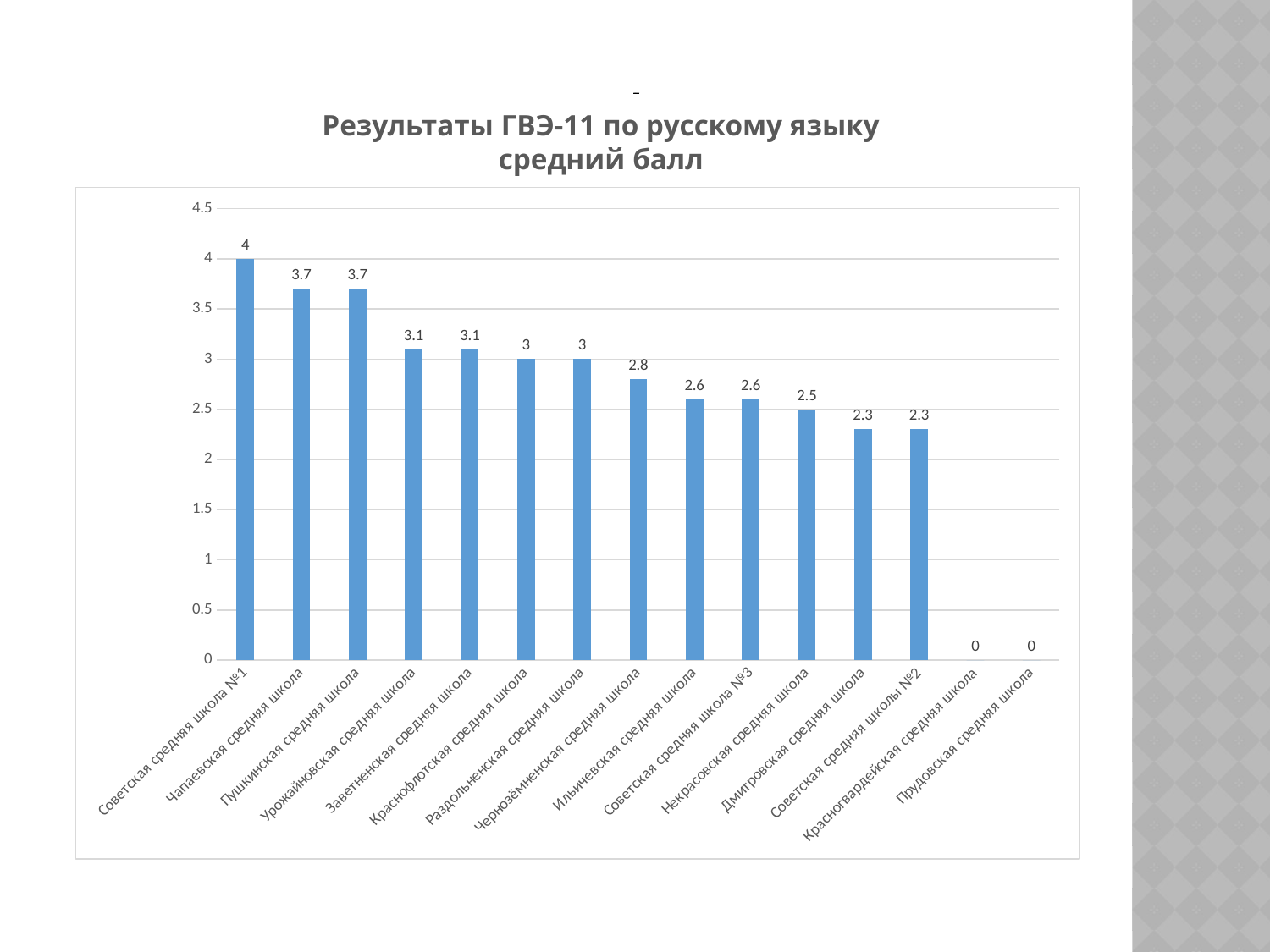
What kind of chart is shown on the slide? bar chart Which school has the highest average score? Советская средняя школа №1 What is the value shown for Чернозёмненская средняя школа? 2.8 What is the value shown for Красногвардейская средняя школа? 0 What is the value shown for Некрасовская средняя школа? 2.5 How many schools are shown on the chart? 15 Do the values rise or fall from left to right along the x axis? fall Which is larger, the value for Пушкинская средняя школа or the value for Ильичевская средняя школа? Пушкинская средняя школа What is the difference between the values for Чапаевская средняя школа and Урожайновская средняя школа? 0.6 Is the value for Заветненская средняя школа greater or less than 3.5? less What is the average score for Советская средняя школа №1? 4 What is the difference between the values for Советская средняя школа №1 and Дмитровская средняя школа? 1.7